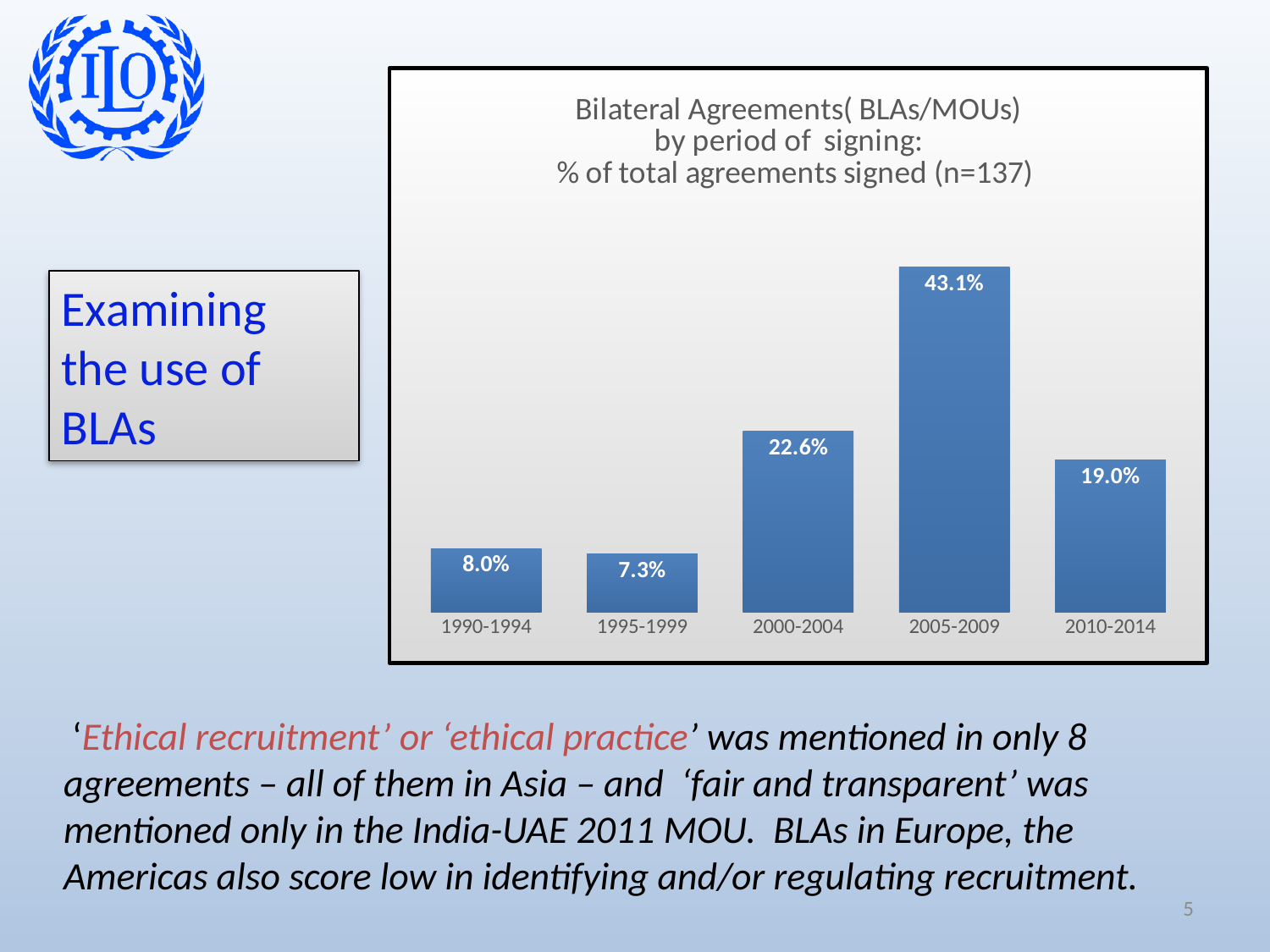
What is the value shown for the 1995-1999 period? 7.3% What is the difference in percentage points between the 2005-2009 and 2000-2004 values? 20.5 Which period has the lowest share of agreements signed? 1995-1999 What percentage of total agreements were signed in 2005-2009? 43.1% Do the values rise or fall from 2005-2009 to 2010-2014? Fall How many periods are shown on the x axis of the chart? 5 What percentage of agreements were signed in 2010-2014? 19.0% Which period has the highest share of agreements signed? 2005-2009 What is the difference in percentage points between the 1990-1994 and 1995-1999 values? 0.7 What is the total number of agreements (n) stated in the chart title? 137 Which period has a larger value, 2000-2004 or 2010-2014? 2000-2004 What kind of chart is shown on the slide? Bar chart